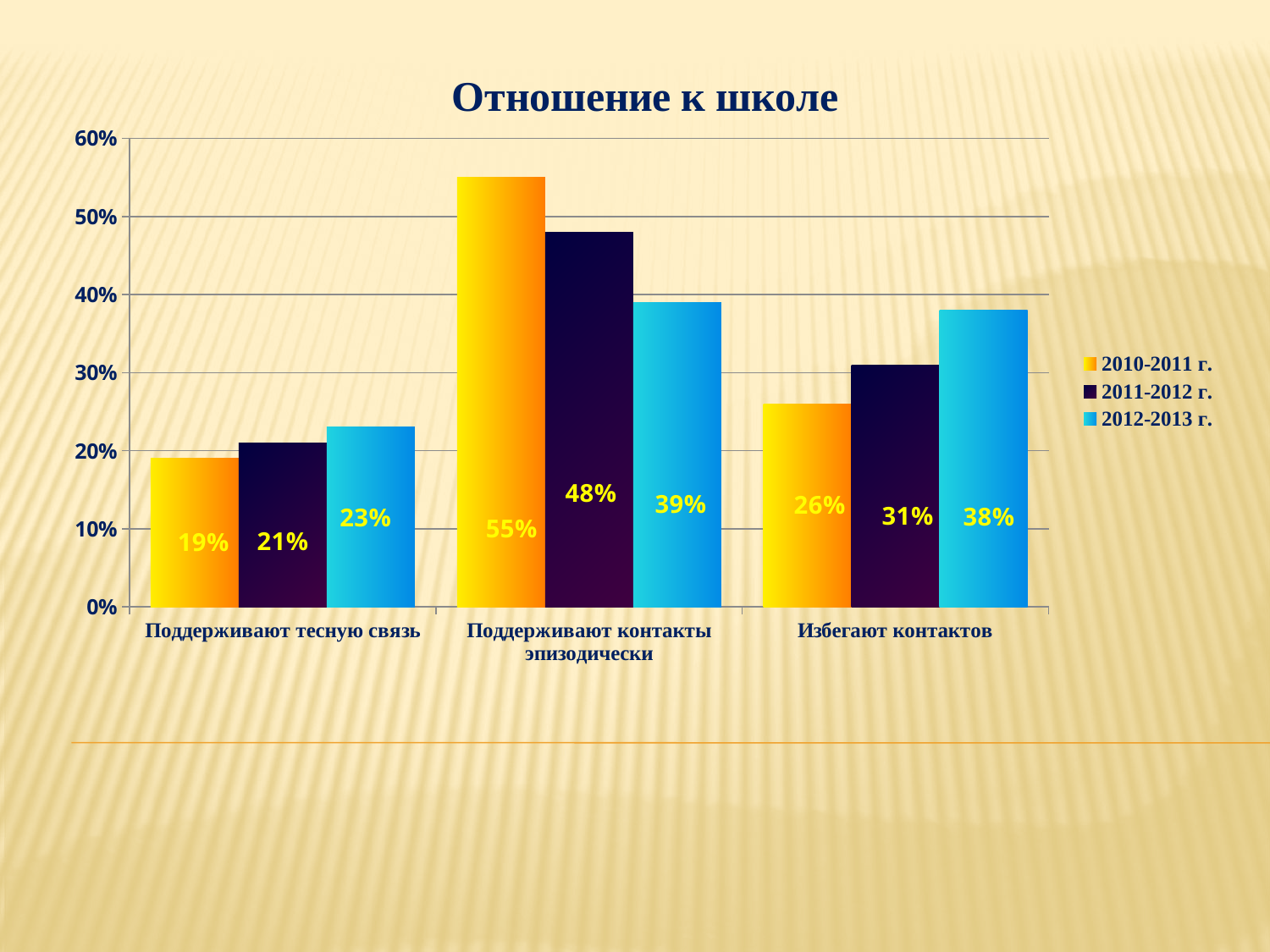
Which category has the lowest value for the 2012-2013 г. series? Поддерживают тесную связь How many series does the legend list? 3 How many categories are shown on the x axis? 3 Is the value for 2010-2011 г. in the category Избегают контактов greater or less than 30%? less Which is larger in the category Избегают контактов: the value for 2011-2012 г. or for 2012-2013 г.? 2012-2013 г. What is the value for 2012-2013 г. in the category Избегают контактов? 38% What is the value for 2010-2011 г. in the category Поддерживают тесную связь? 19% What is the value for 2011-2012 г. in the category Поддерживают контакты эпизодически? 48% What kind of chart is shown on the slide? bar chart What is the difference between the 2010-2011 г. and 2012-2013 г. values in the category Поддерживают контакты эпизодически? 16% Which category has the highest value for the 2010-2011 г. series? Поддерживают контакты эпизодически What is the title of the chart? Отношение к школе